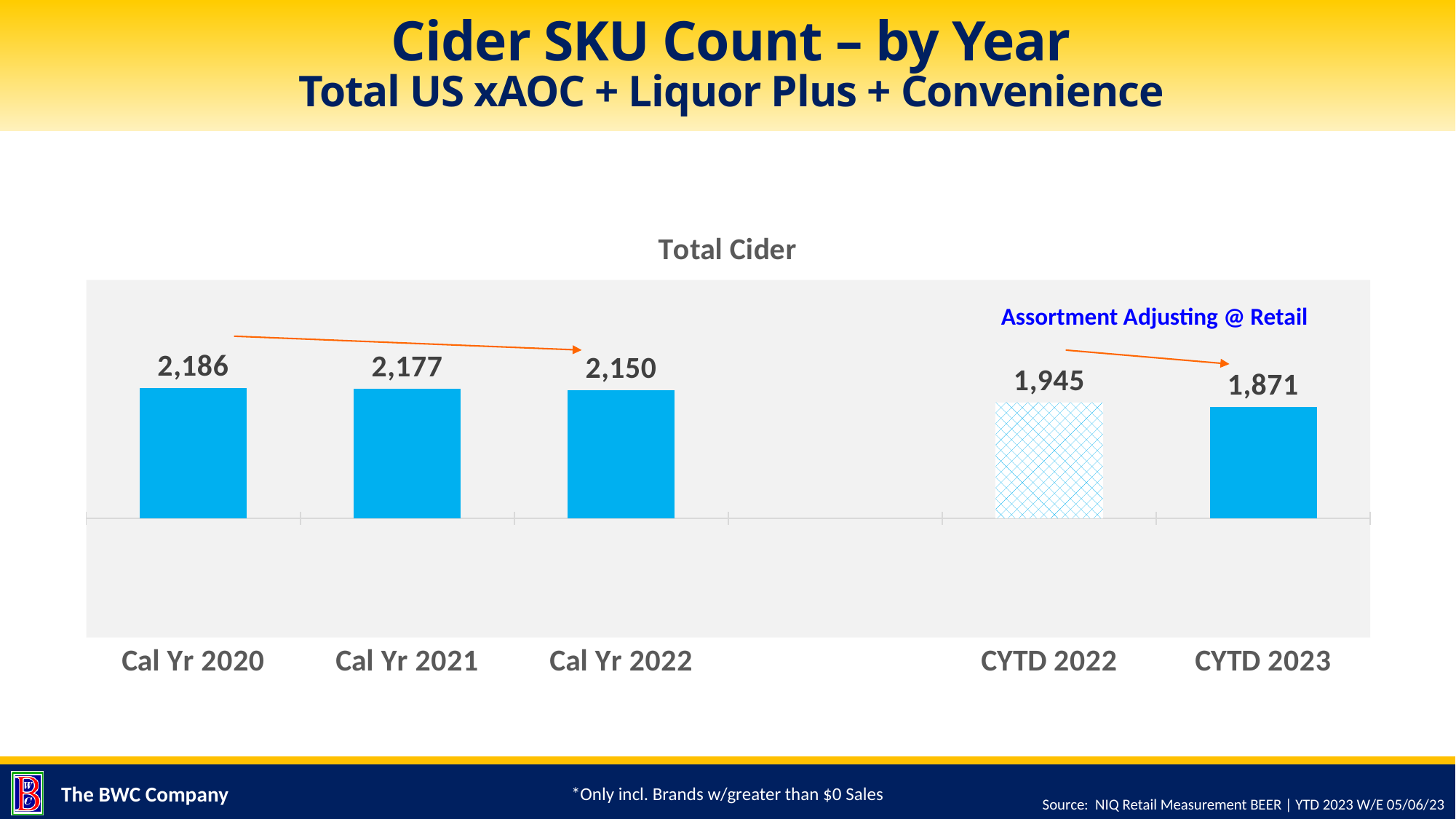
How many periods (bars) are shown in the chart? 5 Which period has the highest Total Cider SKU count? Cal Yr 2020 Do the SKU counts rise or fall from Cal Yr 2020 to Cal Yr 2022? Fall What is the title shown above the chart? Total Cider What kind of chart is shown on the slide? Bar chart What is the Total Cider SKU count for CYTD 2022? 1,945 What is the difference in SKU count between Cal Yr 2020 and Cal Yr 2022? 36 Which is larger, the SKU count for Cal Yr 2021 or for CYTD 2022? Cal Yr 2021 What is the Total Cider SKU count for Cal Yr 2020? 2,186 Which period has the lowest Total Cider SKU count? CYTD 2023 What is the Total Cider SKU count for CYTD 2023? 1,871 What is the difference in SKU count between CYTD 2022 and CYTD 2023? 74